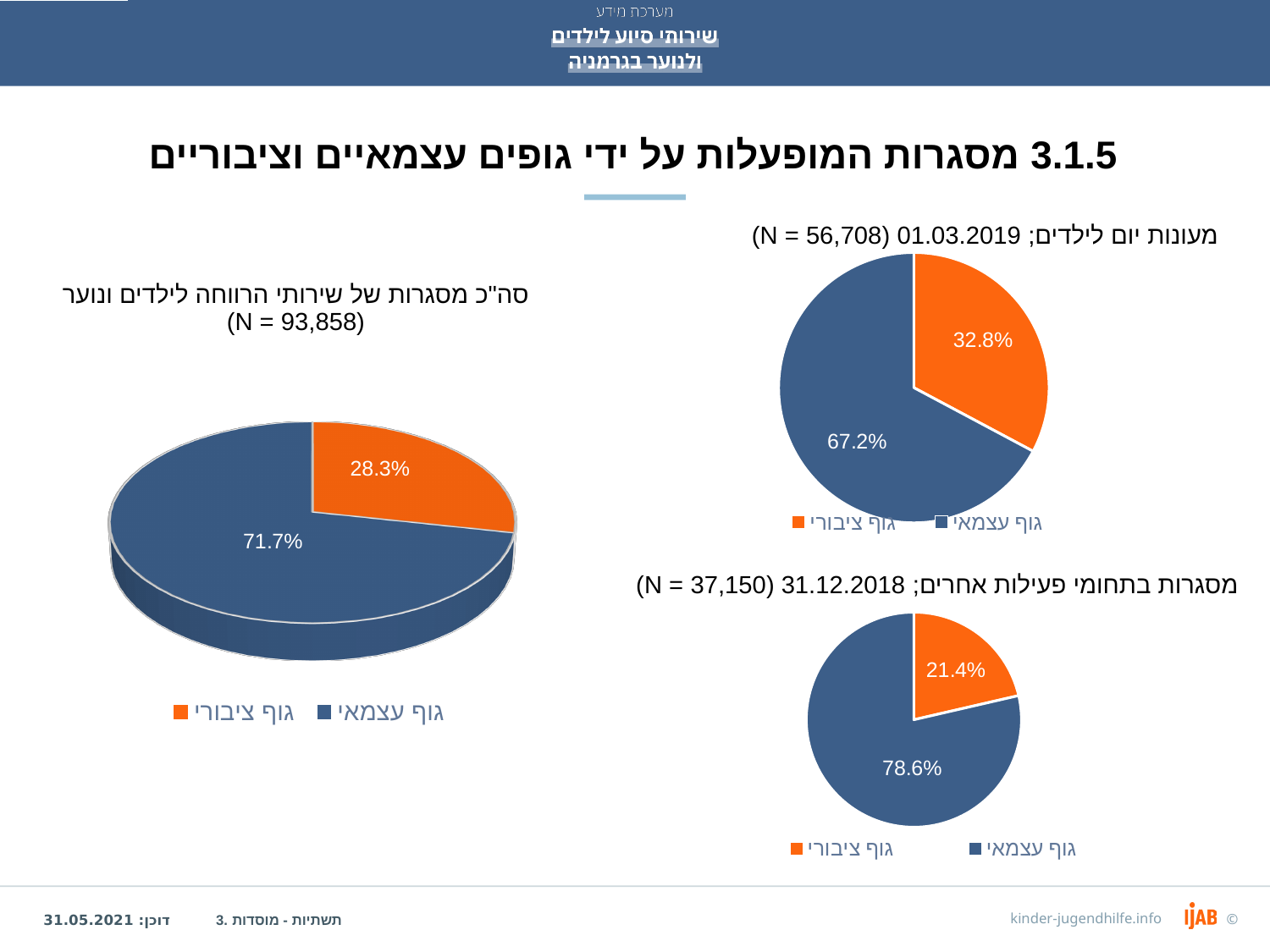
In the chart on the left titled "סה"כ מסגרות של שירותי הרווחה לילדים ונוער", what share is labelled for גוף ציבורי? 28.3% In the chart titled "מסגרות בתחומי פעילות אחרים; 31.12.2018", what share is labelled for גוף ציבורי? 21.4% In the chart titled "מעונות יום לילדים; 01.03.2019", what share is labelled for גוף ציבורי? 32.8% In the chart titled "מעונות יום לילדים; 01.03.2019", what share is labelled for גוף עצמאי? 67.2% How many charts are shown on the slide? 3 In the chart titled "מעונות יום לילדים; 01.03.2019", which category has the larger share? גוף עצמאי How many slices does the chart titled "מעונות יום לילדים; 01.03.2019" have? 2 What kind of chart is the chart titled "מסגרות בתחומי פעילות אחרים; 31.12.2018"? pie chart In the chart titled "מסגרות בתחומי פעילות אחרים; 31.12.2018", what share is labelled for גוף עצמאי? 78.6% In the chart titled "מסגרות בתחומי פעילות אחרים; 31.12.2018", which category has the smaller share? גוף ציבורי In the chart on the left titled "סה"כ מסגרות של שירותי הרווחה לילדים ונוער", what is the difference between the shares of גוף עצמאי and גוף ציבורי? 43.4% In the chart on the left titled "סה"כ מסגרות של שירותי הרווחה לילדים ונוער", what share is labelled for גוף עצמאי? 71.7%